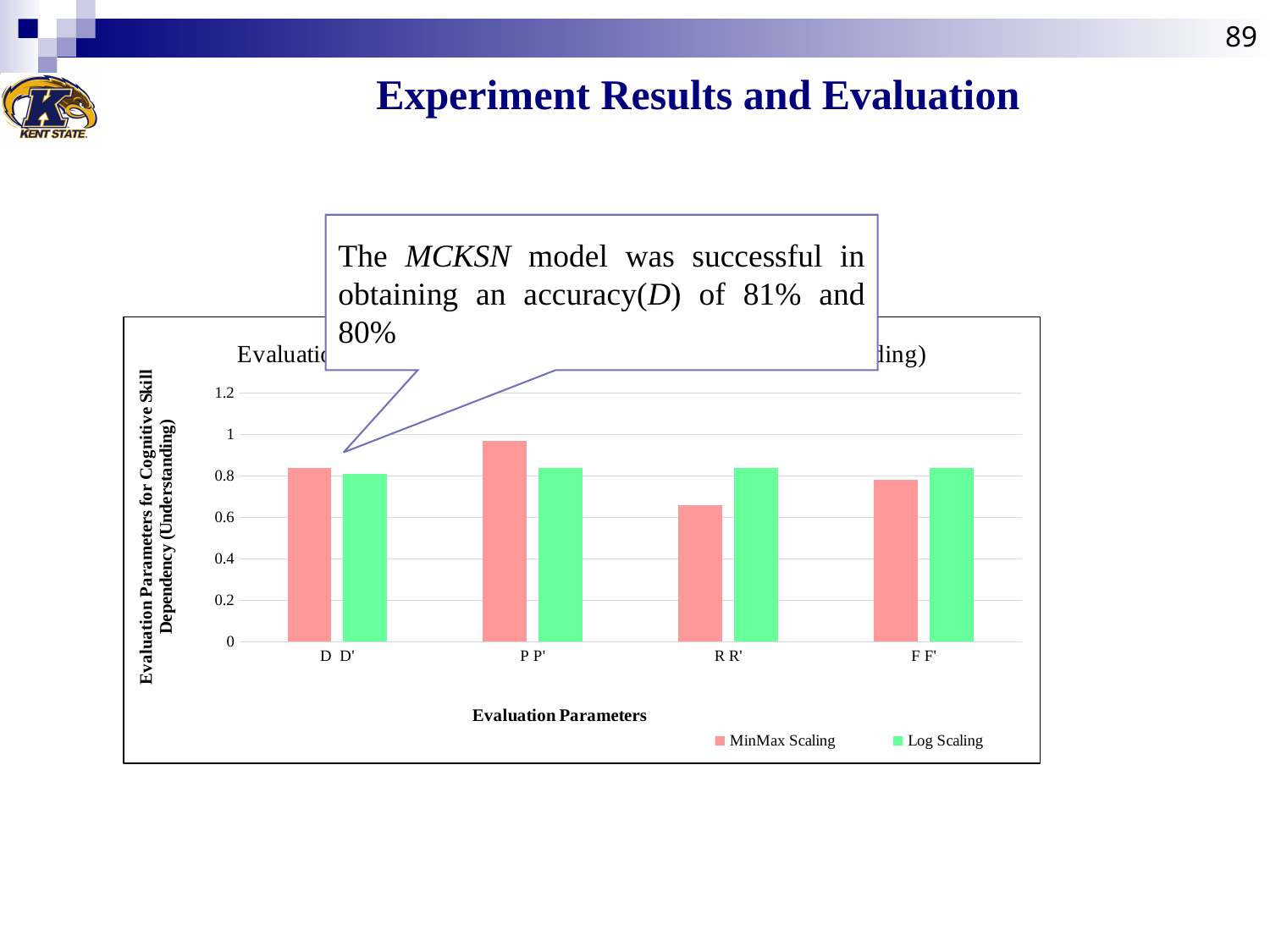
What is the title of the x axis of the chart? Evaluation Parameters Which category has the highest MinMax Scaling value? P P' Is the MinMax Scaling value for R R' greater or less than 0.8? less Which category has the lowest MinMax Scaling value? R R' Which series is shown in pink in the chart? MinMax Scaling What kind of chart is shown on the slide? bar chart How many series does the chart legend list? 2 Is the MinMax Scaling value for P P' greater or less than 0.8? greater For the category P P', which series has the larger value, MinMax Scaling or Log Scaling? MinMax Scaling How many categories are shown on the x axis of the chart? 4 For the category R R', which series has the larger value, MinMax Scaling or Log Scaling? Log Scaling Is the Log Scaling value for F F' greater or less than 0.6? greater